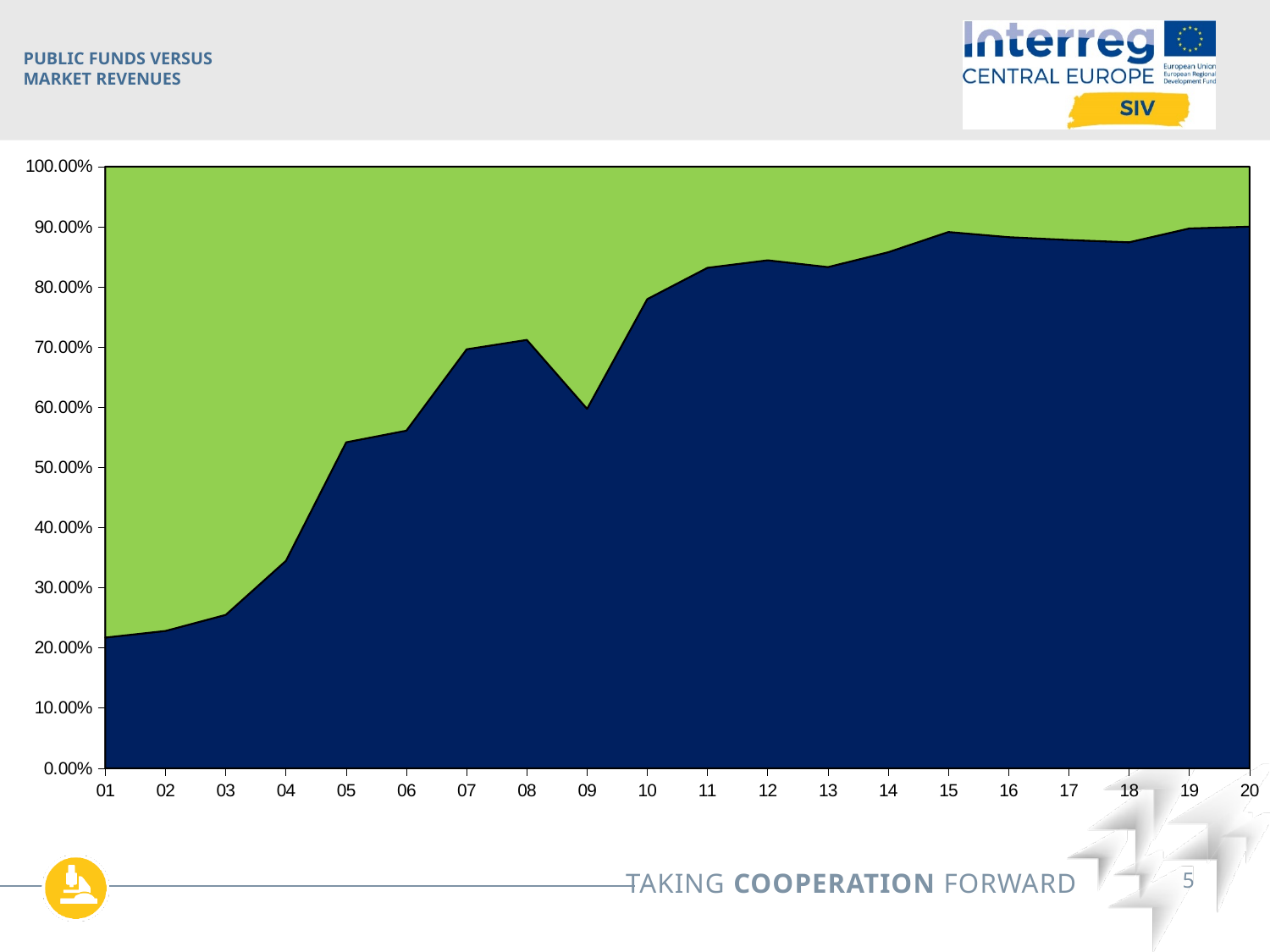
Is the top of the dark blue area at 04 greater or less than 40.00%? less Is the top of the dark blue area at 07 greater or less than 60.00%? greater What is the highest value shown on the y axis of the chart? 100.00% Is the top of the dark blue area at 11 greater or less than 90.00%? less Which has a larger dark blue value, 04 or 05? 05 Does the dark blue area generally rise or fall from 01 to 20? rise What kind of chart is shown on the slide? area chart How many points are plotted along the x axis of the chart? 20 What two colours are used for the areas in the chart? dark blue and green Which has a larger dark blue value, 08 or 09? 08